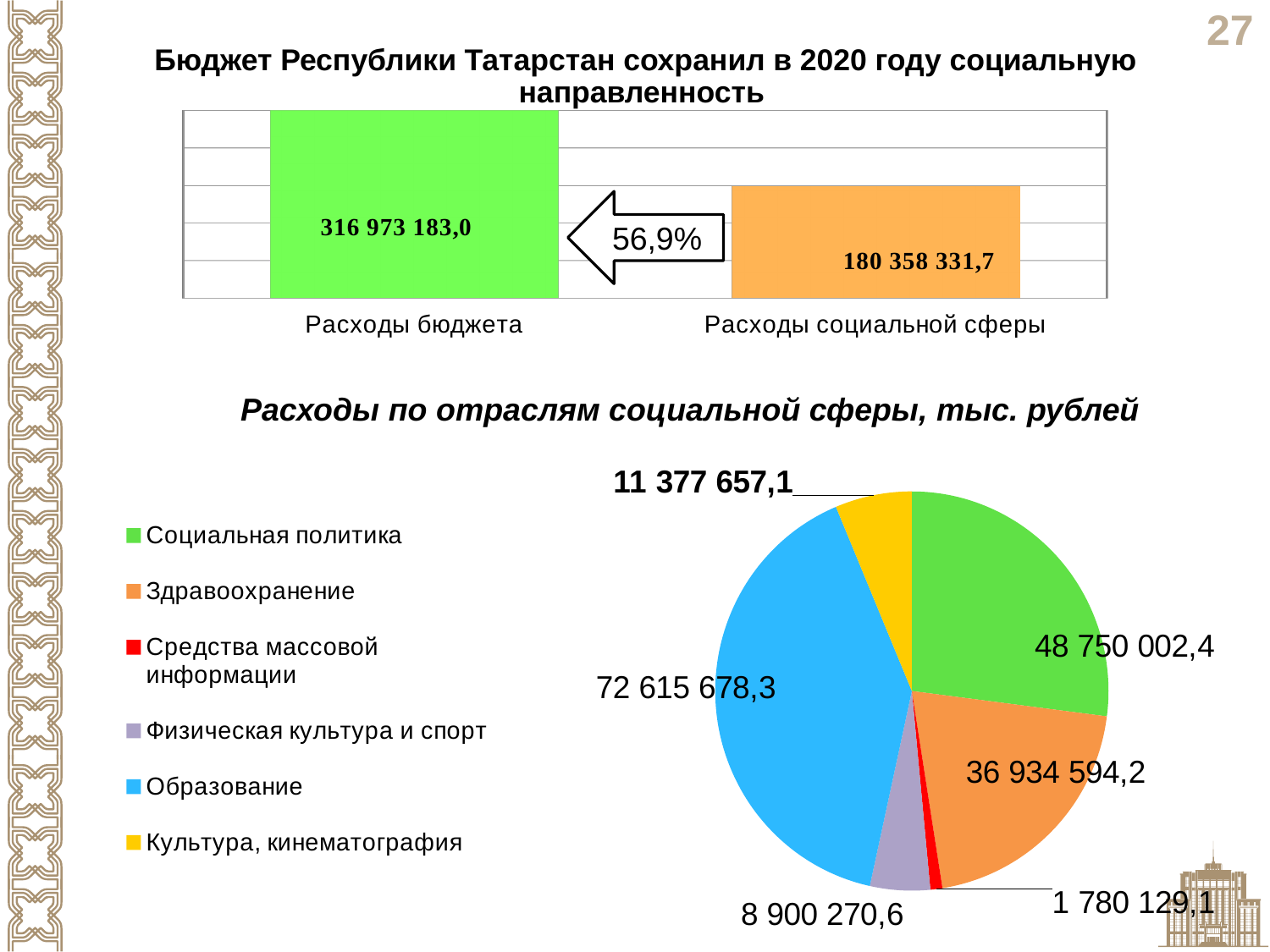
In the pie chart Расходы по отраслям социальной сферы, what is the value for Культура, кинематография? 11 377 657,1 In the pie chart Расходы по отраслям социальной сферы, what is the value for Образование? 72 615 678,3 In the top bar chart, what is the value for Расходы социальной сферы? 180 358 331,7 How many categories does the legend of the pie chart Расходы по отраслям социальной сферы list? 6 What kind of chart is the top chart on the slide? bar chart In the pie chart Расходы по отраслям социальной сферы, what is the value for Здравоохранение? 36 934 594,2 In the top bar chart, what percentage is shown in the arrow between the two bars? 56,9% In the top bar chart, what is the value for Расходы бюджета? 316 973 183,0 In the pie chart Расходы по отраслям социальной сферы, which category has the largest slice? Образование In the pie chart Расходы по отраслям социальной сферы, which category has the smallest slice? Средства массовой информации In the pie chart Расходы по отраслям социальной сферы, which is larger: Социальная политика or Здравоохранение? Социальная политика In the top bar chart, what is the difference between Расходы бюджета and Расходы социальной сферы? 136 614 851,3